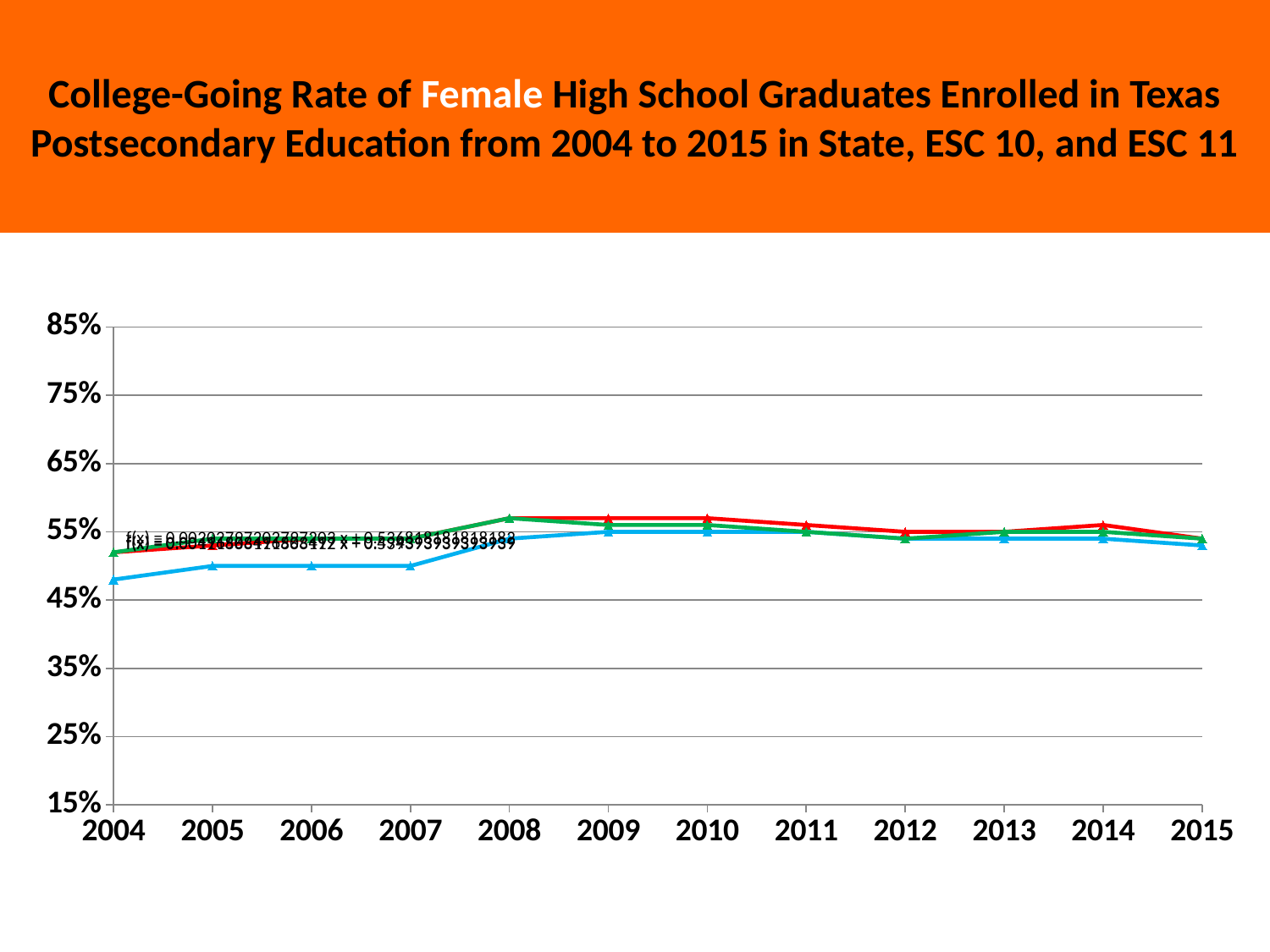
What is the highest value shown on the y axis of the chart? 85% Is the value of the blue line in 2004 greater or less than 55%? less Is the value of the green line in 2008 greater or less than 55%? greater How many years are plotted along the x axis of the chart? 12 In 2004, is the blue line higher or lower than the red line? lower In which year does the blue line reach its lowest value? 2004 Is the value of the blue line in 2004 greater or less than 45%? greater Does the blue line rise or fall from 2004 to 2009? rise Which word in the slide title is highlighted in white? Female What kind of chart is shown on the slide? line chart